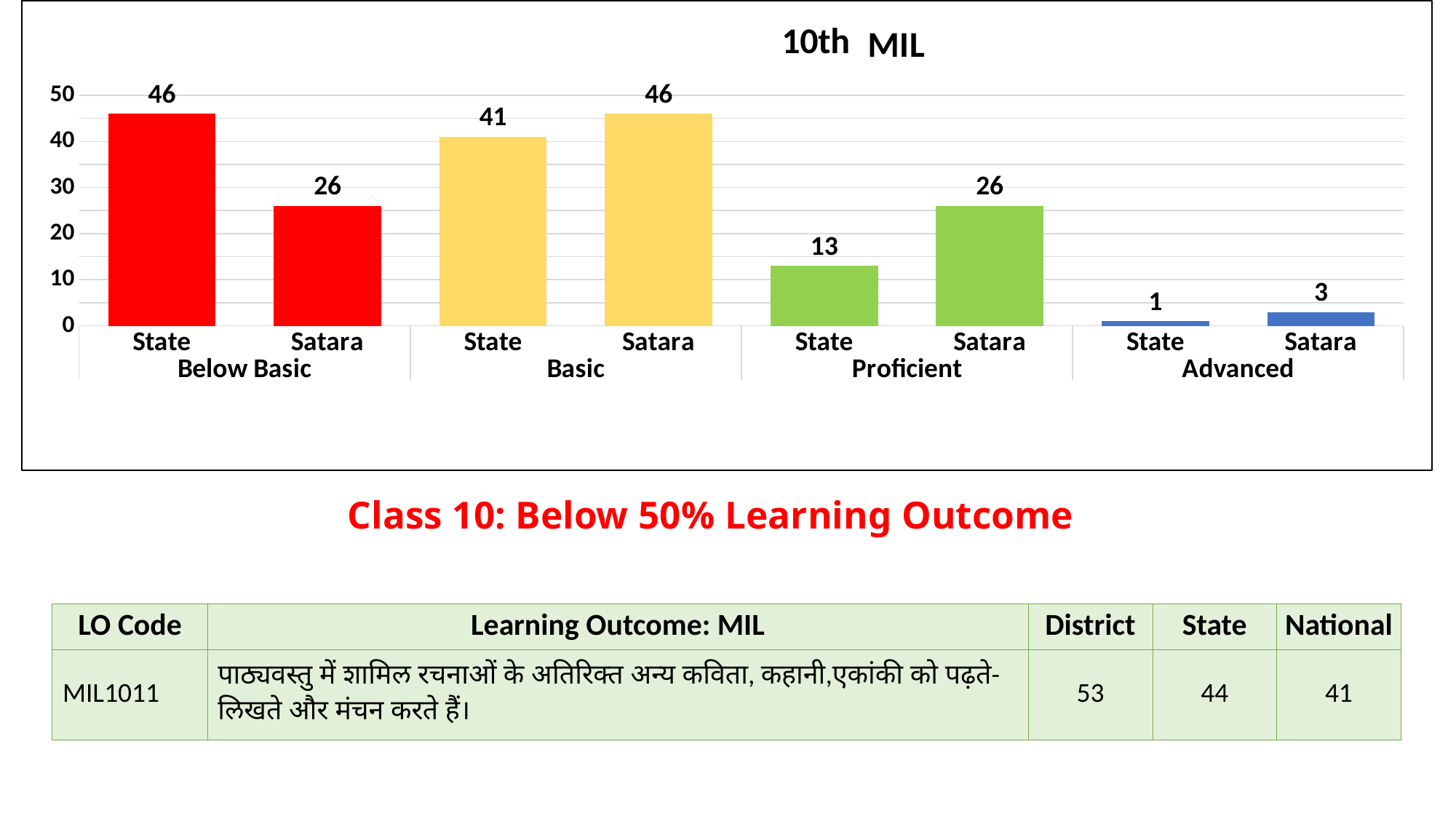
Is the value for Satara in the Proficient group greater or less than 20? greater What is the value for Satara in the Basic group? 46 What is the value for Satara in the Advanced group? 3 In the Basic group, which is larger, State or Satara? Satara What is the difference between the Satara and State values in the Proficient group? 13 How many bars are plotted in the chart? 8 Which bar has the lowest value in the chart? State, Advanced What is the value for State in the Below Basic group? 46 What is the title of the chart? 10th MIL What is the value for State in the Proficient group? 13 What kind of chart is shown on the slide? bar chart What is the difference between the State and Satara values in the Below Basic group? 20